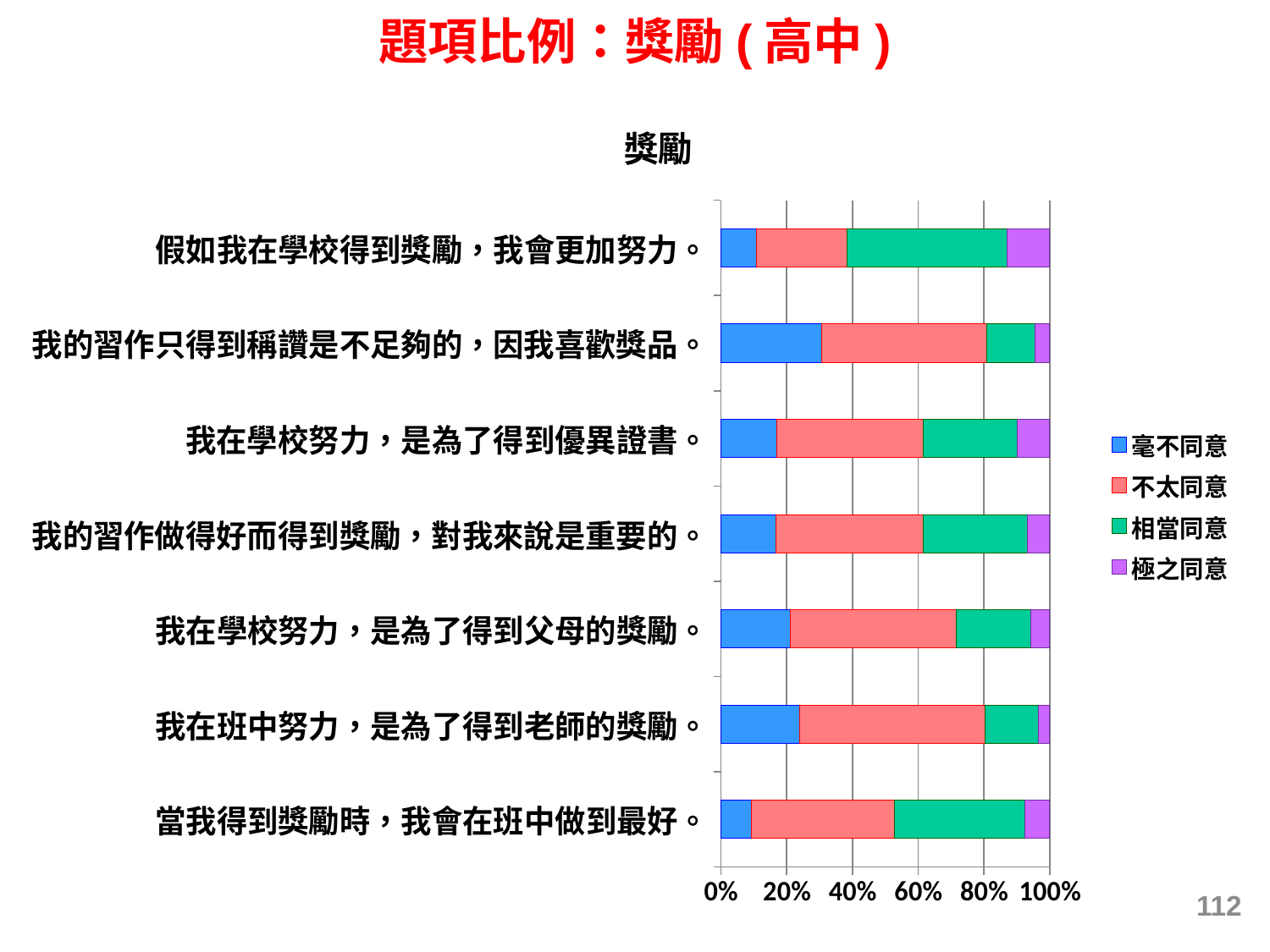
What kind of chart is shown on the slide? Stacked bar chart Which has the larger 毫不同意 segment: "我的習作只得到稱讚是不足夠的，因我喜歡獎品。" or "假如我在學校得到獎勵，我會更加努力。"? 我的習作只得到稱讚是不足夠的，因我喜歡獎品。 Which legend entry is shown in red/pink? 不太同意 Which has the larger 相當同意 segment: "假如我在學校得到獎勵，我會更加努力。" or "我在班中努力，是為了得到老師的獎勵。"? 假如我在學校得到獎勵，我會更加努力。 Is the 毫不同意 share for "假如我在學校得到獎勵，我會更加努力。" greater or less than 20%? less Is the 相當同意 share for "假如我在學校得到獎勵，我會更加努力。" greater or less than 40%? greater How many series does the legend list? 4 Which statement has the largest 相當同意 segment? 假如我在學校得到獎勵，我會更加努力。 Which statement has the largest 毫不同意 segment? 我的習作只得到稱讚是不足夠的，因我喜歡獎品。 What is the title of the chart? 獎勵 Is the 毫不同意 share for "我的習作只得到稱讚是不足夠的，因我喜歡獎品。" greater or less than 20%? greater How many statements (categories) are plotted in the chart? 7